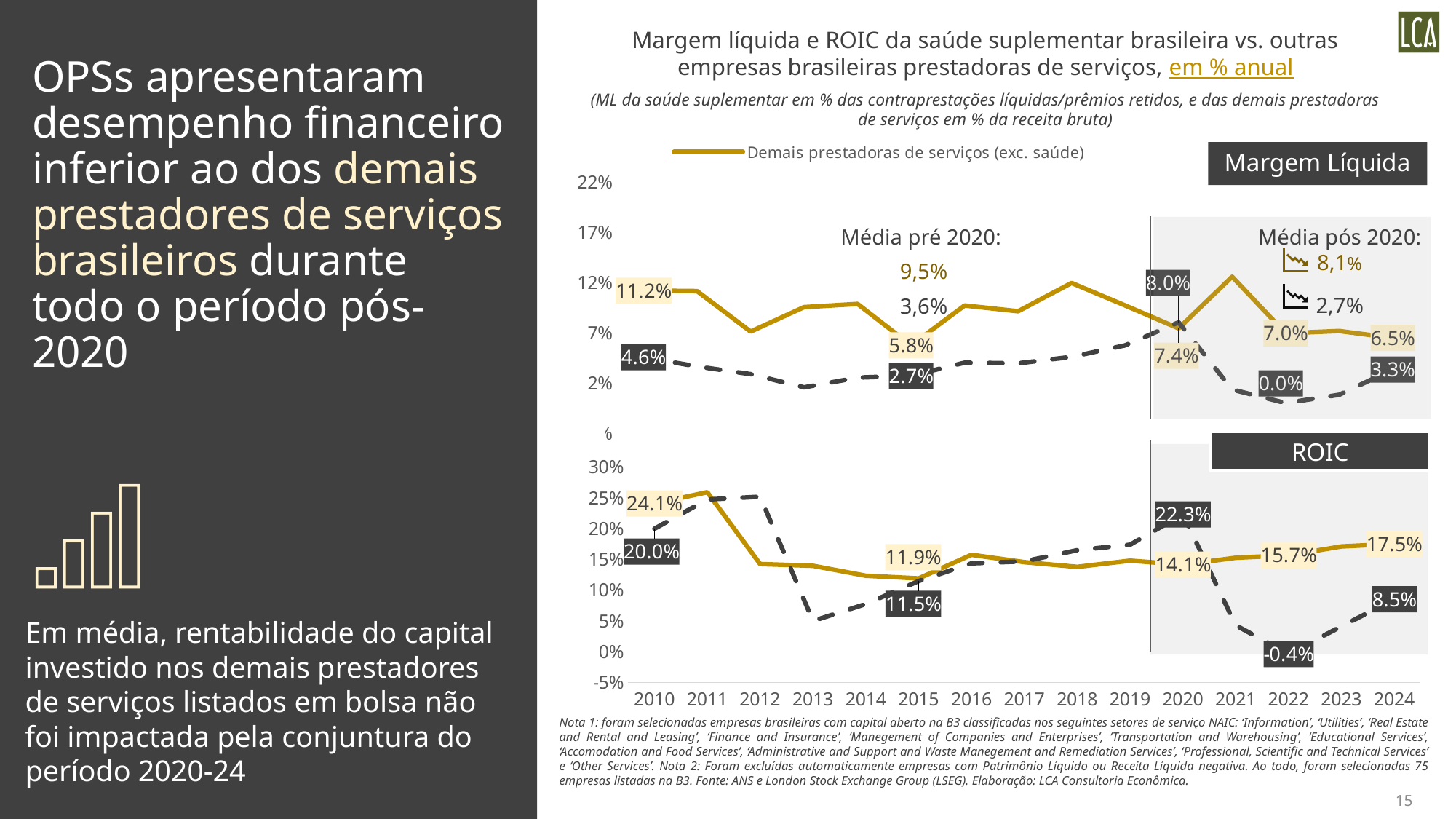
In the Margem Líquida chart, what is the difference between the 2024 values of the gold line (6.5%) and the dashed line (3.3%)? 3.2 percentage points In the Margem Líquida chart, which series has the higher value in 2020: the gold 'Demais prestadoras' line or the dark dashed line? The dark dashed line In the ROIC chart, does the dark dashed line rise or fall from 2020 to 2022? Fall In the Margem Líquida chart, what is the value of the dark dashed line in 2022? 0.0% How many years are shown on the x axis of the charts? 15 In the ROIC chart, is the value of the dark dashed line in 2013 greater or less than 10%? less In the Margem Líquida chart, what is the 'Média pré 2020' shown for the gold 'Demais prestadoras de serviços' line? 9,5% In the ROIC chart, what is the value of the 'Demais prestadoras de serviços (exc. saúde)' line in 2024? 17.5% What type of chart is used for the Margem Líquida and ROIC panels? Line chart In the Margem Líquida chart, what is the value of the 'Demais prestadoras de serviços (exc. saúde)' line in 2010? 11.2% In the ROIC chart, which series has the higher value in 2022: the gold 'Demais prestadoras' line or the dark dashed line? Demais prestadoras de serviços (exc. saúde) In the ROIC chart, what is the value of the dark dashed line in 2020? 22.3%